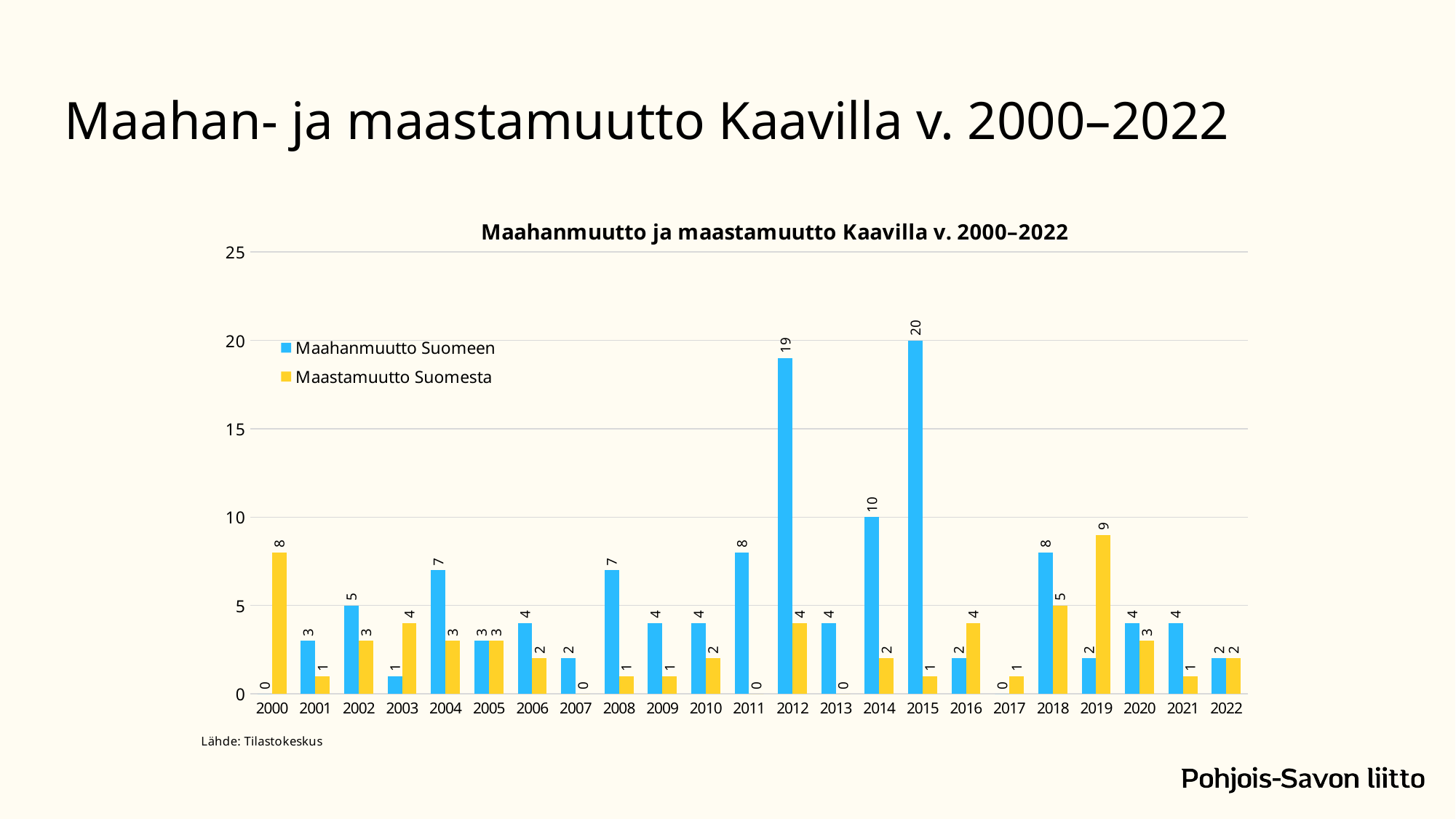
What kind of chart is shown on the slide? Bar chart Which is larger in 2016, Maahanmuutto Suomeen or Maastamuutto Suomesta? Maastamuutto Suomesta In which year is Maahanmuutto Suomeen highest? 2015 What is the difference between Maahanmuutto Suomeen and Maastamuutto Suomesta in 2015? 19 What is the value of Maahanmuutto Suomeen in 2012? 19 How many years are shown on the x axis of the chart? 23 Which is larger in 2018, Maahanmuutto Suomeen or Maastamuutto Suomesta? Maahanmuutto Suomeen How many series does the legend list? 2 What is the difference between Maahanmuutto Suomeen in 2012 and in 2014? 9 What is the value of Maastamuutto Suomesta in 2019? 9 In which year is Maastamuutto Suomesta highest? 2019 What is the value of Maastamuutto Suomesta in 2000? 8